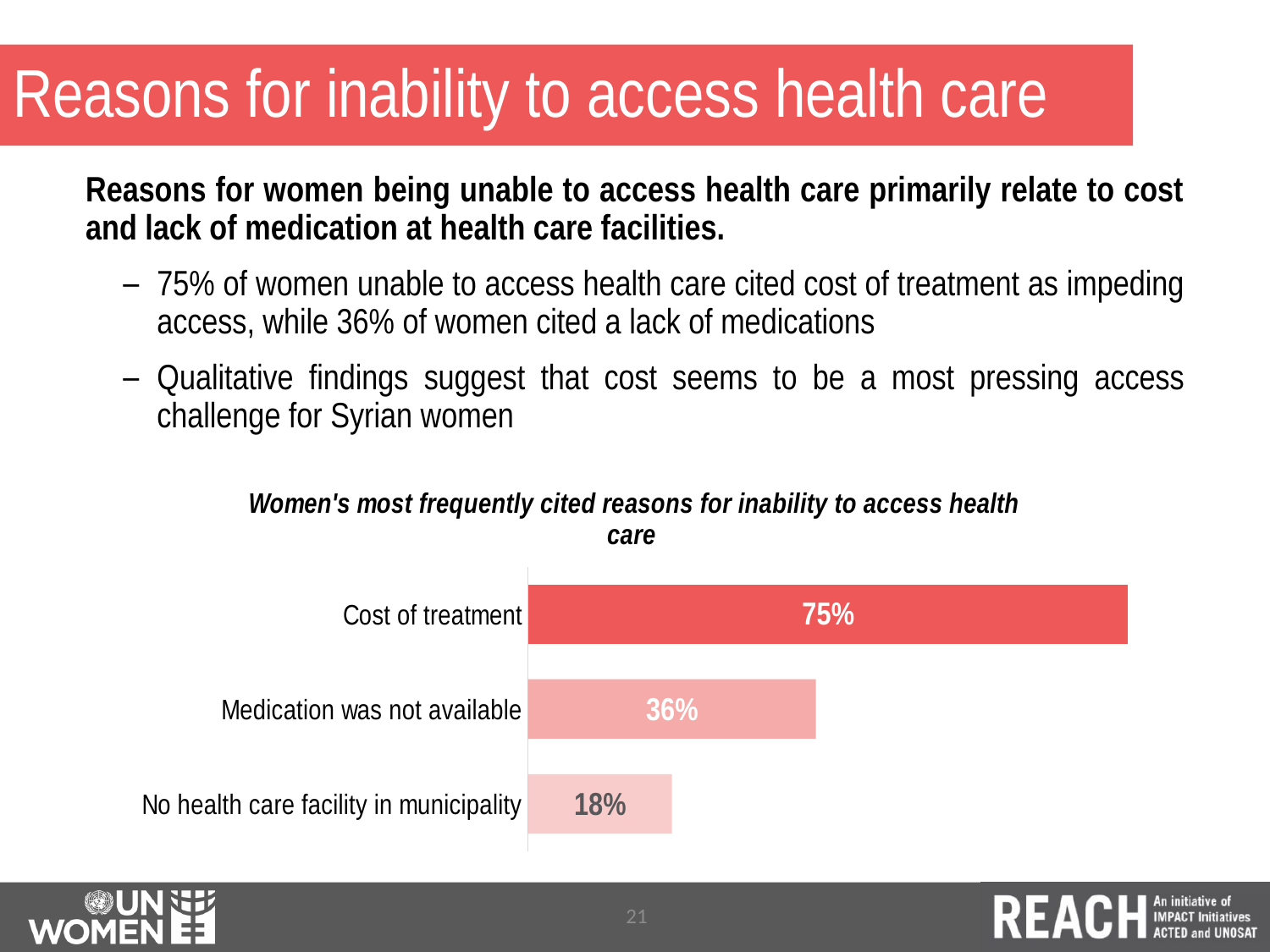
How many reasons are shown in the chart? 3 What value is shown for 'No health care facility in municipality'? 18% What is the difference between the values for 'Cost of treatment' and 'Medication was not available'? 39% What is the title of the chart? Women's most frequently cited reasons for inability to access health care Which reason has the highest value in the chart? Cost of treatment Which is larger: the value for 'Medication was not available' or for 'No health care facility in municipality'? Medication was not available What value is shown for 'Medication was not available'? 36% What kind of chart is shown on the slide? Bar chart Which reason has the lowest value in the chart? No health care facility in municipality Do the bar values decrease from the top bar to the bottom bar? Yes What percentage of women cited cost of treatment as a reason for inability to access health care? 75% What is the difference between the values for 'Medication was not available' and 'No health care facility in municipality'? 18%